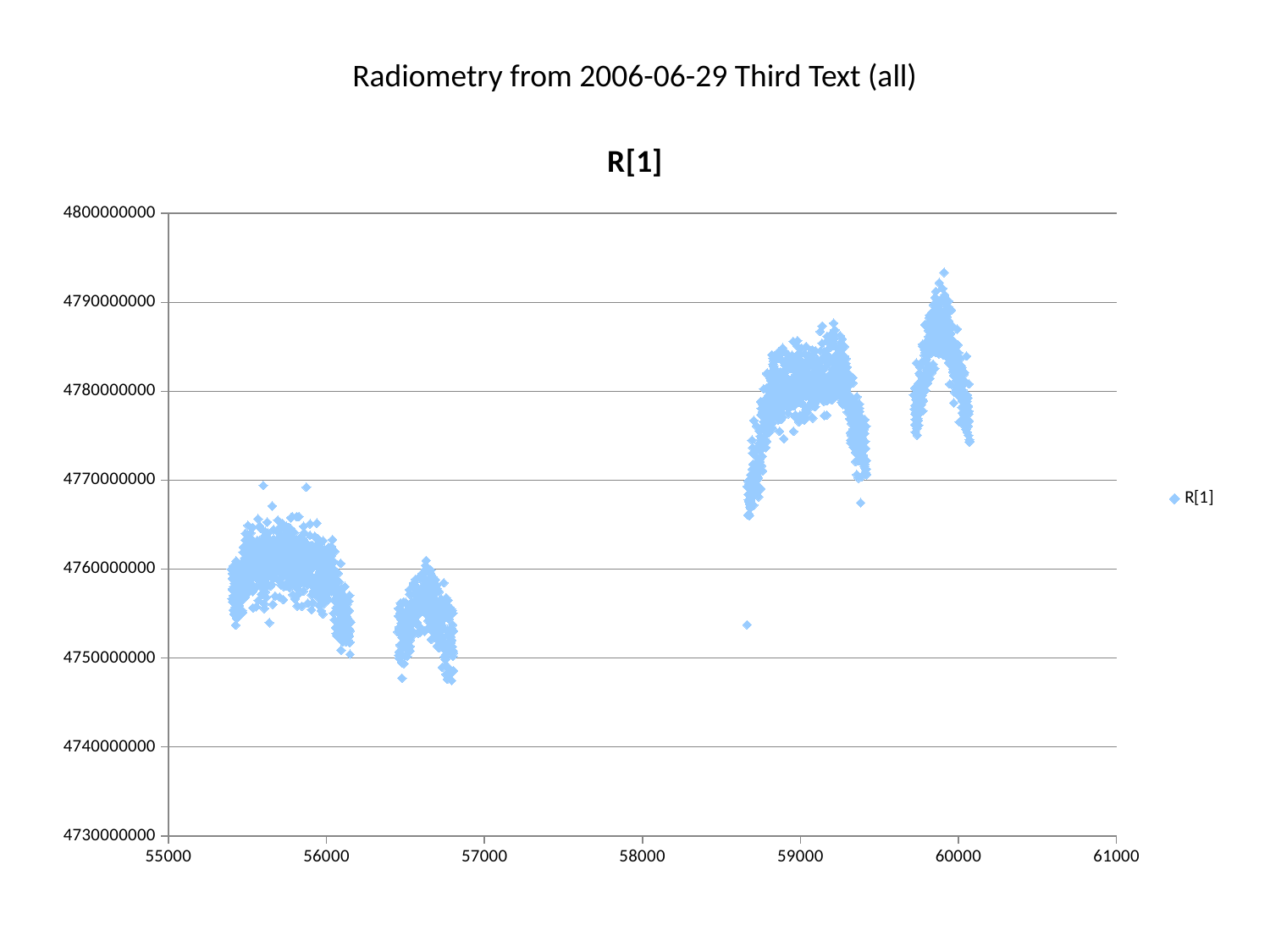
How many series does the legend list? 1 Are the R[1] values in the cluster near x = 59900 greater or less than 4770000000? greater Which cluster of points has higher R[1] values: the one near x = 55700 or the one near x = 59900? the one near x = 59900 What is the title of the chart? R[1] Which cluster of points has lower R[1] values: the one near x = 56600 or the one near x = 59000? the one near x = 56600 Are the R[1] values in the cluster near x = 59000 greater or less than 4760000000? greater What is the name of the series shown in the legend? R[1] What is the highest value shown on the y-axis? 4800000000 Are the R[1] values in the cluster near x = 56600 greater or less than 4770000000? less Do the R[1] values generally rise or fall as the x-axis value increases from 55000 to 61000? rise What kind of chart is shown on the slide? scatter chart